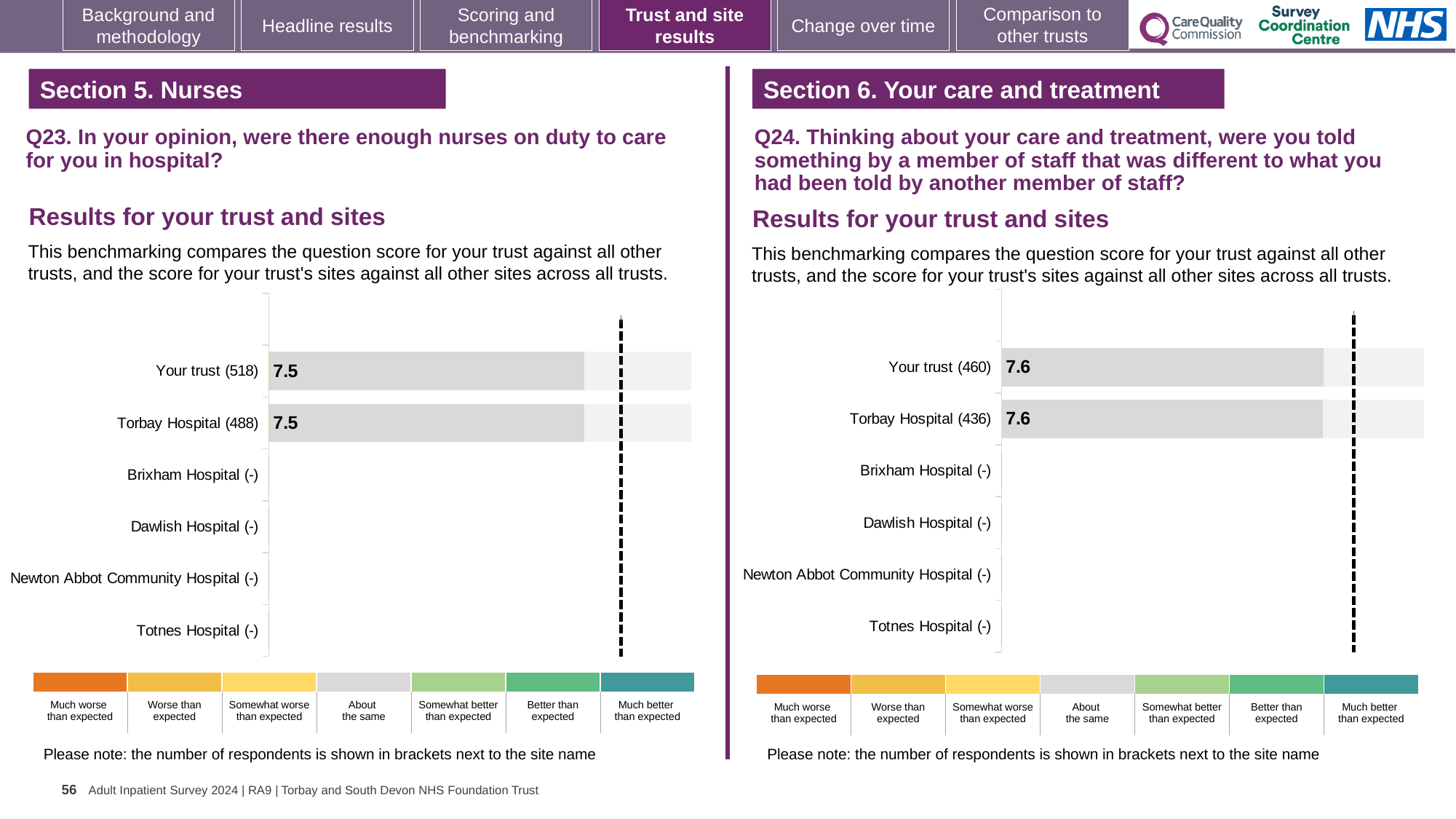
In the Q23 chart on the left, what is the score for Torbay Hospital (488)? 7.5 In the Q24 chart on the right, what is the score for Torbay Hospital (436)? 7.6 In the Q24 chart on the right, what is the difference between the scores for Your trust and Torbay Hospital? 0 In the Q24 chart on the right, how many respondents are shown in brackets for Your trust? 460 In the Q23 chart on the left, how many respondents are shown in brackets for Torbay Hospital? 488 How many site/trust categories are listed on the y axis of the Q24 chart on the right? 6 How many site/trust categories are listed on the y axis of the Q23 chart on the left? 6 In the Q23 chart on the left, what is the score for Your trust (518)? 7.5 In the Q23 chart on the left, how many categories have a plotted bar with a printed value? 2 In the Q23 chart on the left, what is the difference between the scores for Your trust and Torbay Hospital? 0 What kind of chart is used for the Q23 results on the left? Bar chart In the Q24 chart on the right, what is the score for Your trust (460)? 7.6